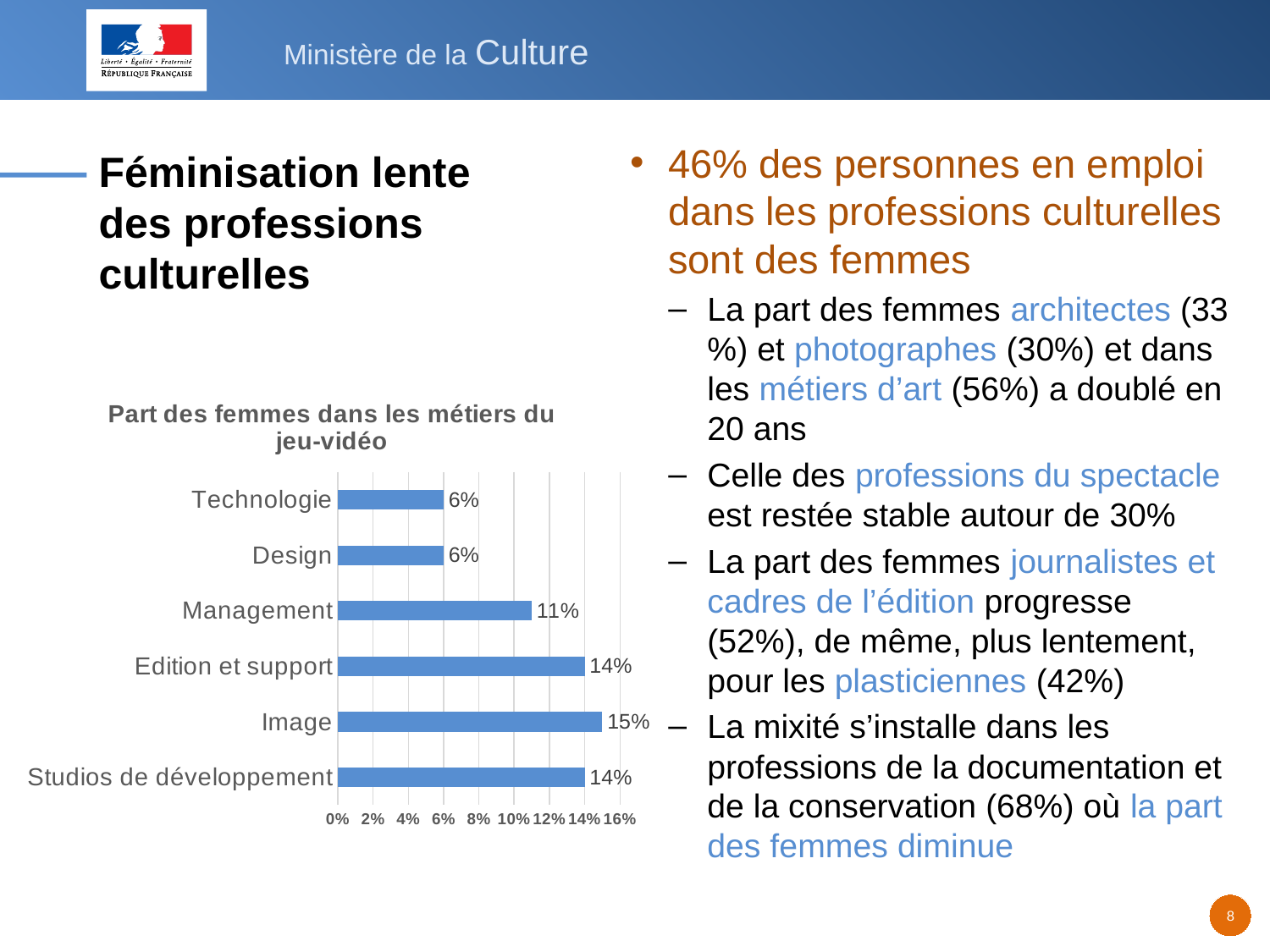
What is the difference between the values for Image and Technologie? 9% What is the maximum value shown on the x axis of the chart? 16% How many categories are shown in the chart? 6 What is the difference between the values for Edition et support and Management? 3% Which is larger, the value for Management or the value for Design? Management Is the value for Edition et support greater or less than 10%? greater What is the value for Image in the chart 'Part des femmes dans les métiers du jeu-vidéo'? 15% Which category has the highest value in the chart? Image What is the title of the chart on the slide? Part des femmes dans les métiers du jeu-vidéo What is the value for Management in the chart? 11% What is the value for Studios de développement? 14% What kind of chart is shown on the slide? Bar chart